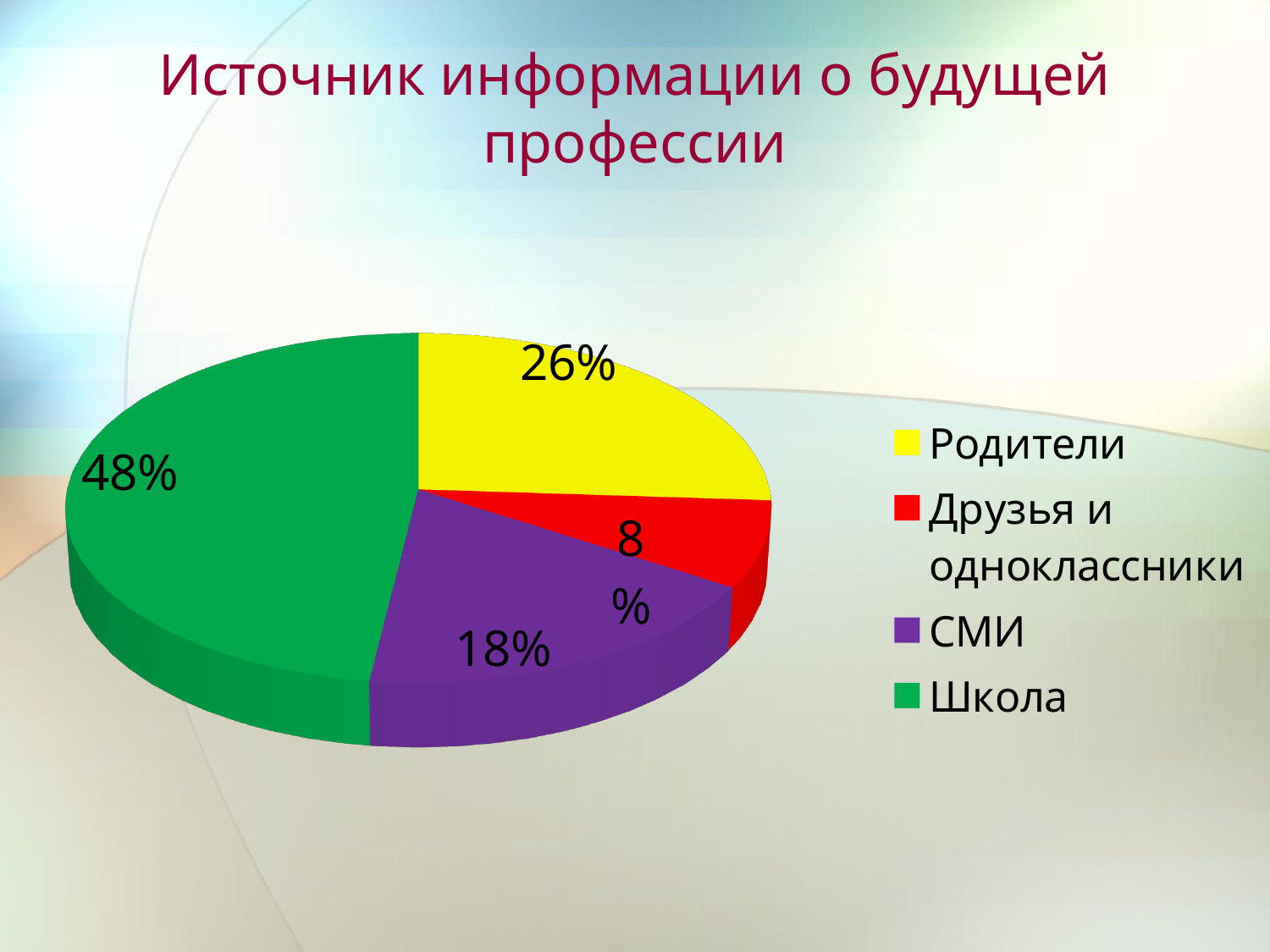
How many categories does the pie chart show? 4 What is the difference between the values for СМИ and Друзья и одноклассники? 10% What is the difference between the values for Школа and Родители? 22% Which is larger, the value for Родители or the value for СМИ? Родители Which category has the smallest slice of the pie? Друзья и одноклассники Which category has the largest slice of the pie? Школа What share of the pie does Школа account for? 48% What is the value shown for Родители? 26% What kind of chart is shown on the slide? Pie chart What is the title of the chart? Источник информации о будущей профессии What is the value shown for СМИ? 18% What is the value shown for Друзья и одноклассники? 8%